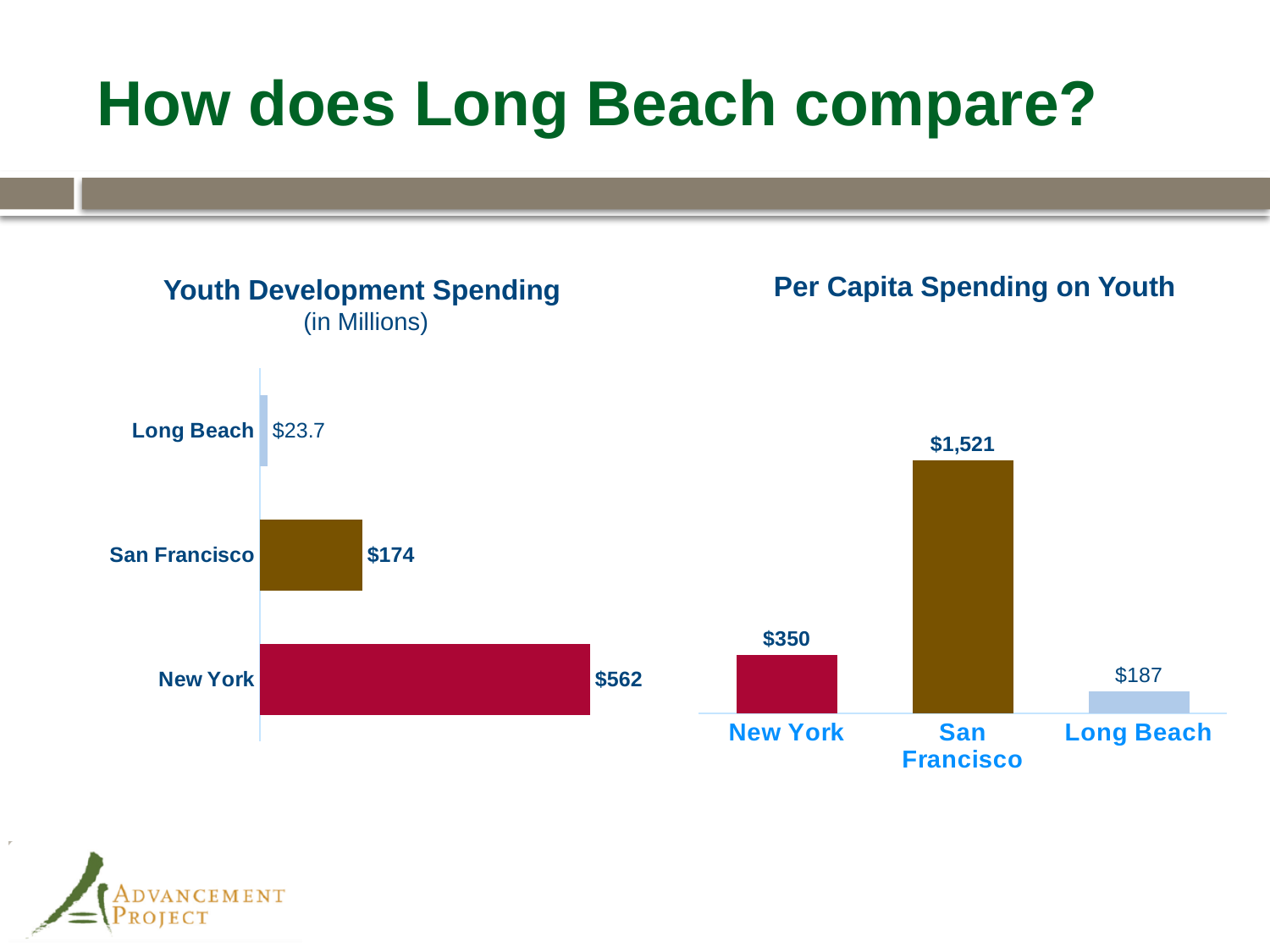
In the Per Capita Spending on Youth chart, what is the value for Long Beach? $187 What is the subtitle under the title of the left chart? (in Millions) In the Per Capita Spending on Youth chart, what is the difference between New York and Long Beach? $163 In the Youth Development Spending chart, what is the value for Long Beach? $23.7 What kind of chart is the Per Capita Spending on Youth chart? Bar chart In the Per Capita Spending on Youth chart, which city has the lowest value? Long Beach How many cities are shown in the Youth Development Spending chart? 3 In the Per Capita Spending on Youth chart, what is the value for San Francisco? $1,521 In the Youth Development Spending chart, what is the value for New York? $562 In the Per Capita Spending on Youth chart, which is larger, New York or San Francisco? San Francisco In the Youth Development Spending chart, which city has the highest value? New York In the Youth Development Spending chart, what is the difference between New York and San Francisco? $388